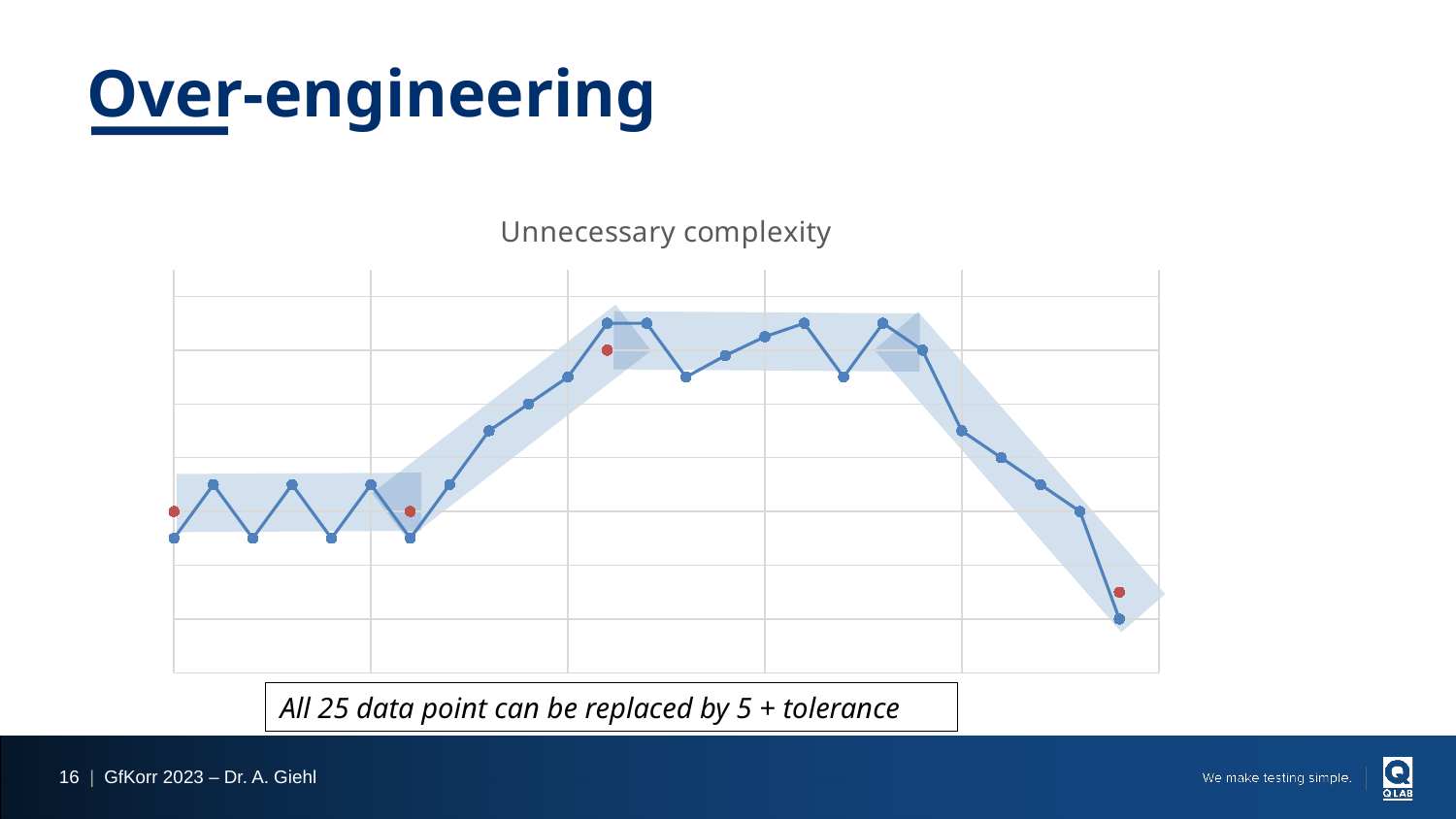
How many red points are shown on the chart? 5 Does the line rise or fall over the rightmost section of the chart? fall Does the line rise or fall between the flat zigzag section on the left and the plateau in the middle? rise How many blue data points are plotted on the line? 25 Which point on the line is the lowest? the last (rightmost) point What is the title of the chart? Unnecessary complexity What kind of chart is shown on the slide? line chart According to the caption below the chart, how many points plus a tolerance can replace all the data points? 5 + tolerance